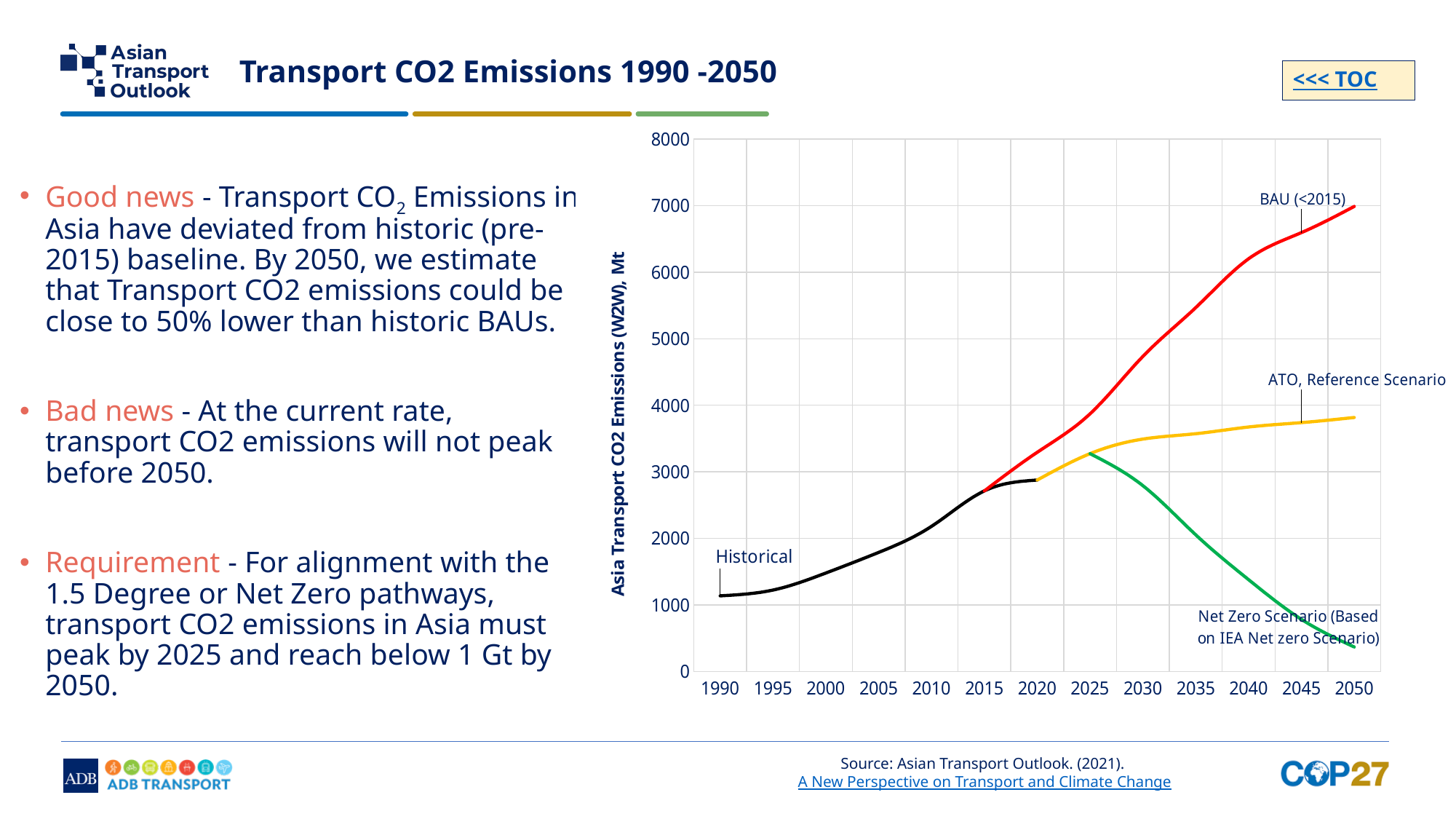
Does the Historical line rise or fall between 1990 and 2020? rise Is the BAU (<2015) value in 2050 greater or less than 6000? greater In 2050, which is larger: the BAU (<2015) value or the ATO, Reference Scenario value? BAU (<2015) What kind of chart is shown on the slide? line chart Is the ATO, Reference Scenario value in 2050 greater or less than 4000? less Which scenario has the lowest value in 2050? Net Zero Scenario (Based on IEA Net zero Scenario) Which scenario has the highest value in 2050? BAU (<2015) What is the label of the vertical axis of the chart? Asia Transport CO2 Emissions (W2W), Mt Is the Net Zero Scenario value in 2050 greater or less than 1000? less Does the Net Zero Scenario line rise or fall between 2025 and 2050? fall How many labelled series (lines) does the chart show? 4